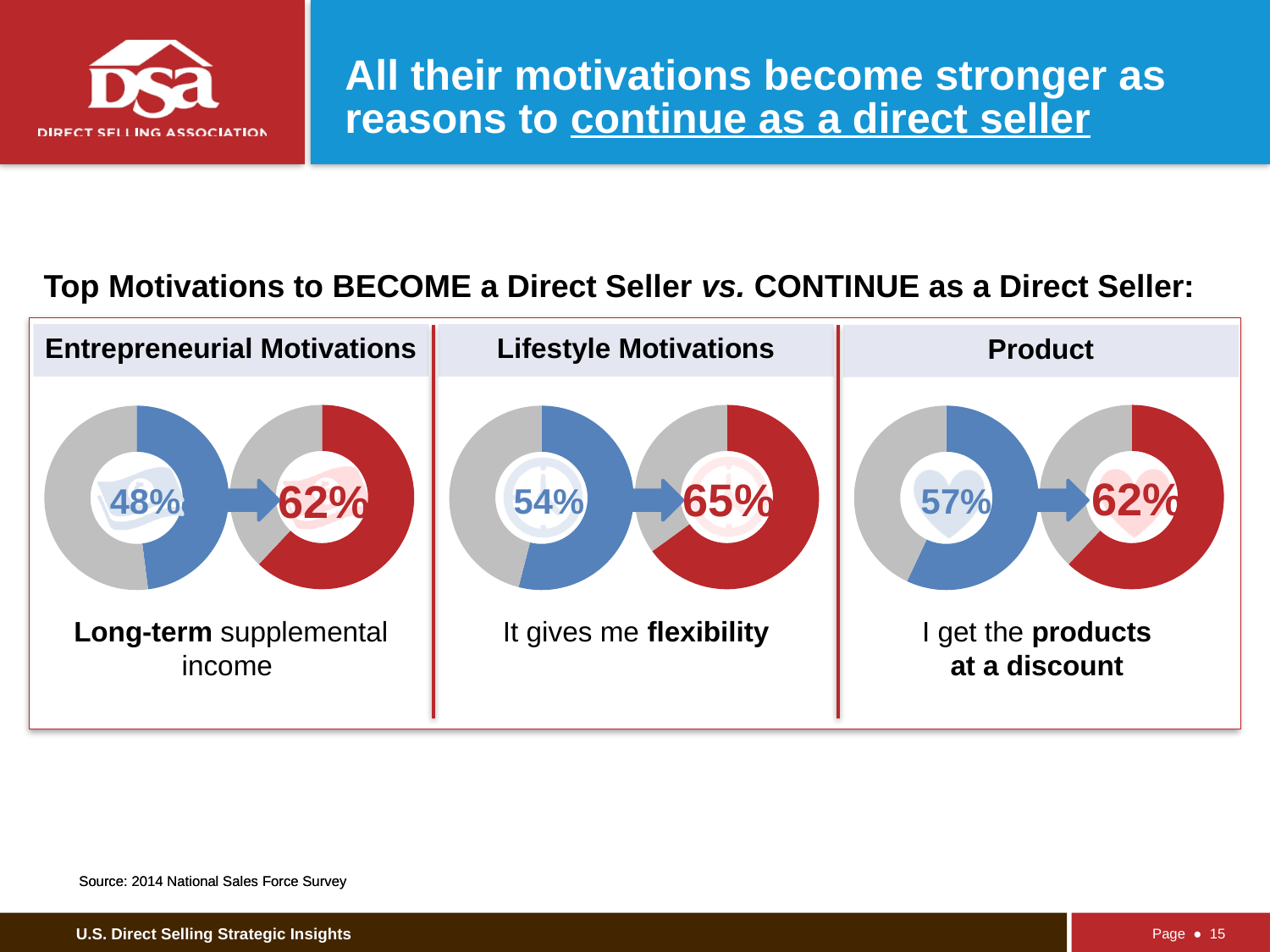
In the Lifestyle Motivations panel, what percentage is shown in the red donut chart for 'It gives me flexibility'? 65% Which panel's red donut chart shows the highest percentage for continuing as a direct seller? Lifestyle Motivations In the Entrepreneurial Motivations panel, what percentage is shown in the red donut chart for 'Long-term supplemental income' as a reason to continue as a direct seller? 62% In the Lifestyle Motivations panel, what is the difference between the red donut value and the blue donut value? 11% How many donut charts are shown on the slide in total? 6 In the Entrepreneurial Motivations panel, what percentage is shown in the blue donut chart for 'Long-term supplemental income' as a reason to become a direct seller? 48% In the Entrepreneurial Motivations panel, what is the difference between the red donut value (62%) and the blue donut value (48%)? 14% In the Product panel, what percentage is shown in the red donut chart for 'I get the products at a discount'? 62% What type of chart is used to display the percentages on this slide? Donut (pie) chart Which panel's blue donut chart shows the lowest percentage for becoming a direct seller? Entrepreneurial Motivations In the Product panel, what percentage is shown in the blue donut chart for 'I get the products at a discount'? 57% In the Lifestyle Motivations panel, what percentage is shown in the blue donut chart for 'It gives me flexibility'? 54%